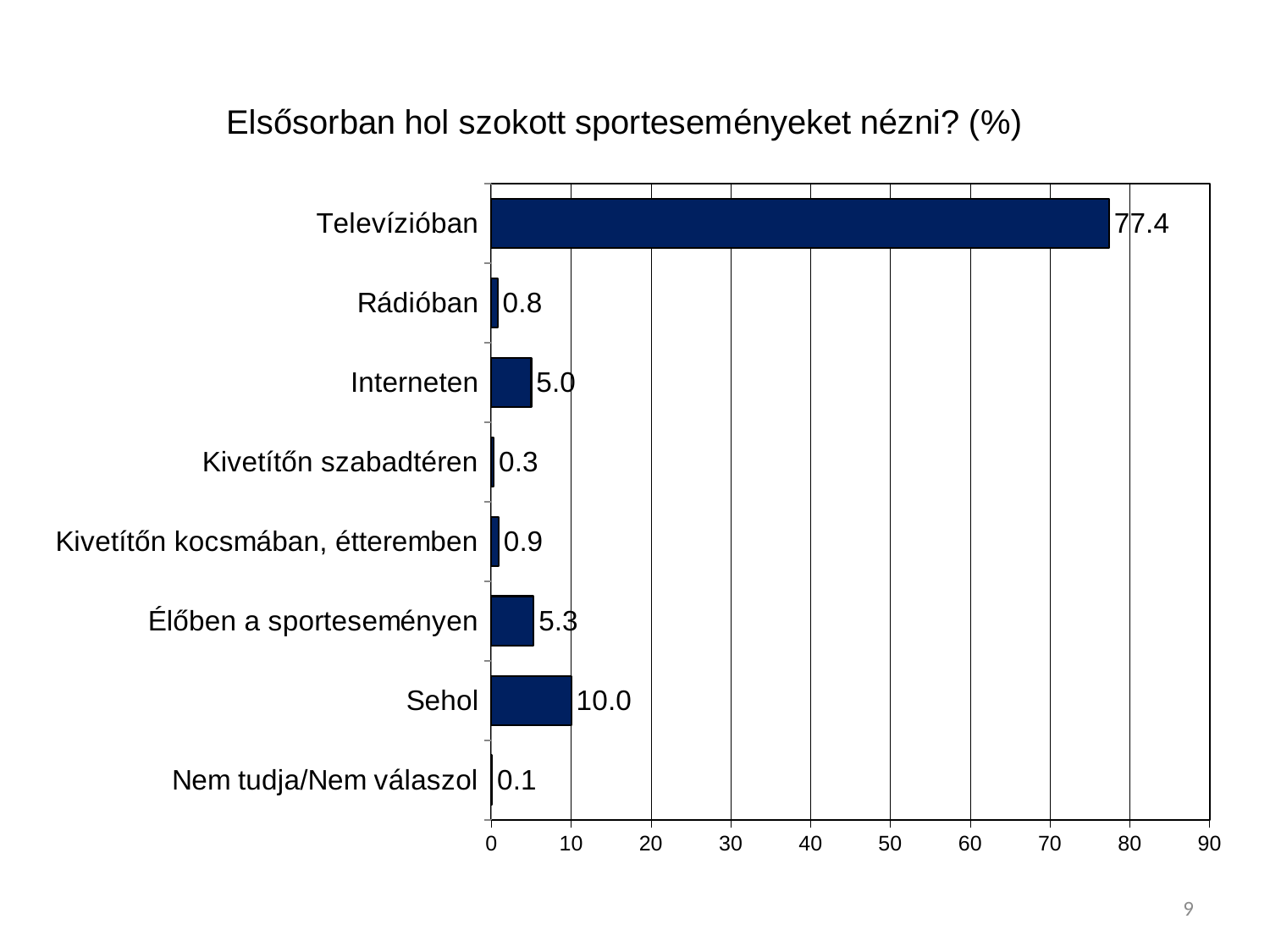
Which category has the highest value? Televízióban What is the difference between the values for Élőben a sporteseményen and Interneten? 0.3 What is the value for Sehol? 10.0 What kind of chart is shown on the slide? bar chart Is the value for Televízióban greater or less than 70? greater How many categories are shown in the chart? 8 What is the title of the chart? Elsősorban hol szokott sporteseményeket nézni? (%) What is the value for Kivetítőn kocsmában, étteremben? 0.9 Which category has the lowest value? Nem tudja/Nem válaszol Which is larger, the value for Interneten or the value for Élőben a sporteseményen? Élőben a sporteseményen What is the difference between the values for Televízióban and Sehol? 67.4 What is the value for Televízióban? 77.4